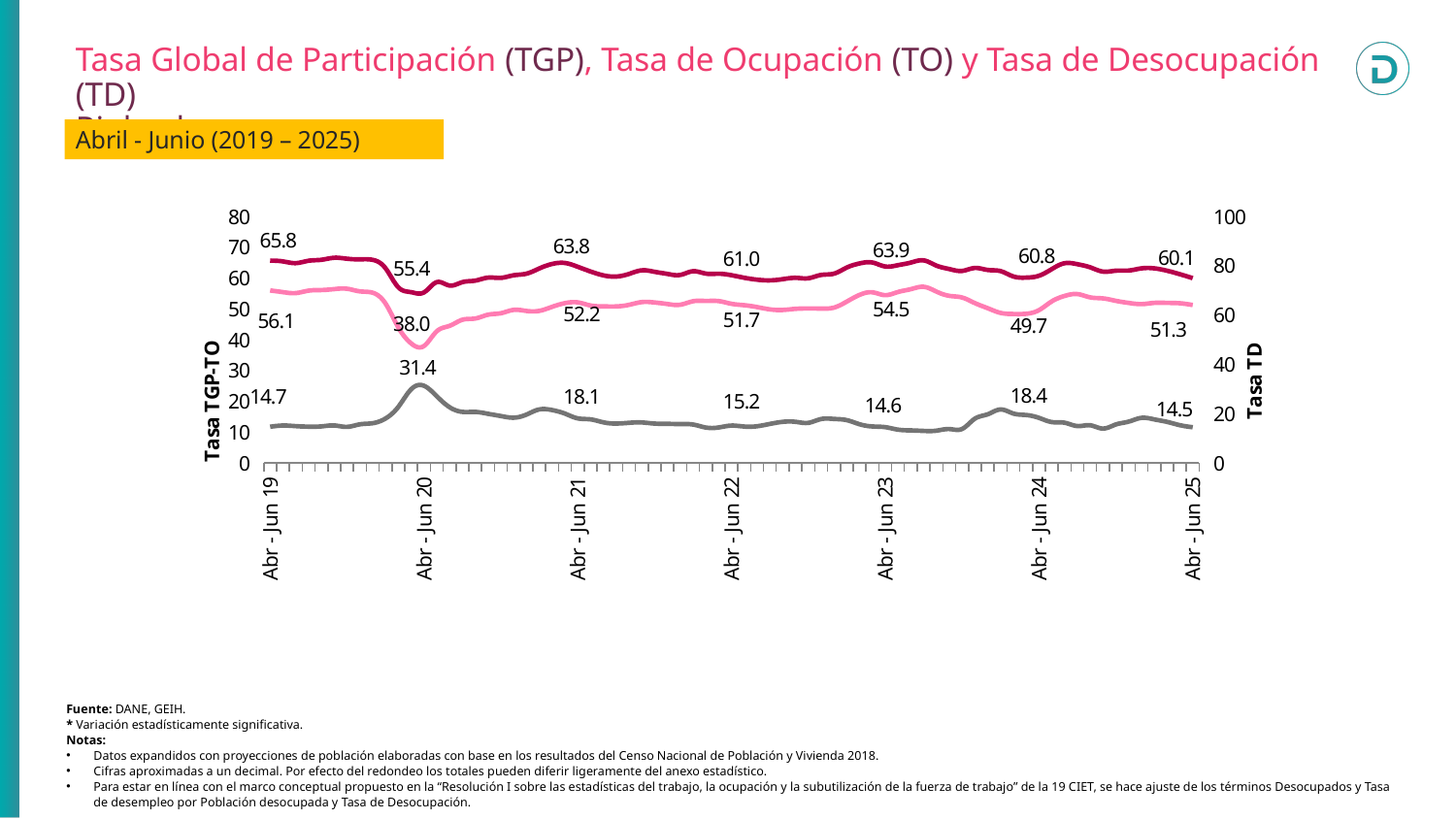
What is the difference between the TD value for Abr - Jun 20 and the TD value for Abr - Jun 19? 16.7 What is the TD value for Abr - Jun 25? 14.5 Which is larger, the TO value for Abr - Jun 23 or the TO value for Abr - Jun 24? Abr - Jun 23 What is the TD value for Abr - Jun 20? 31.4 In which labeled period is the TGP (Tasa Global de Participación) lowest? Abr - Jun 20 In which labeled period is the TD (Tasa de Desocupación) highest? Abr - Jun 20 What is the TGP value for Abr - Jun 19? 65.8 How many labeled Abr - Jun periods are shown on the x axis? 7 What is the difference between the TGP value for Abr - Jun 19 and the TGP value for Abr - Jun 25? 5.7 What is the title of the right-hand vertical axis? Tasa TD What is the TO value for Abr - Jun 20? 38.0 What kind of chart is shown on the slide? Line chart